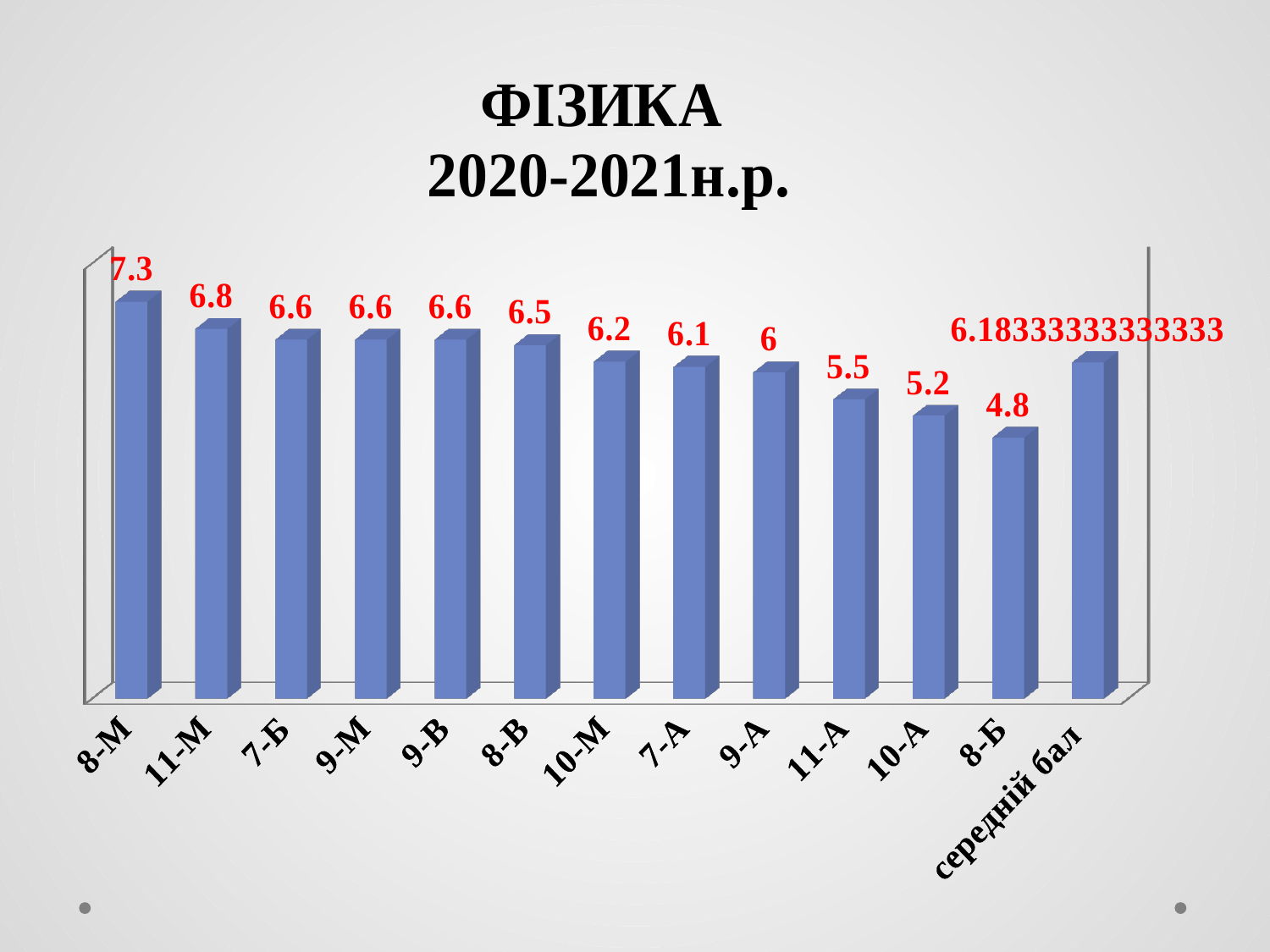
Which class has the highest value? 8-М What is the difference between the values for 11-М and 11-А? 1.3 Which is larger, the value for 7-А or the value for 8-В? 8-В What is the title of the chart? ФІЗИКА 2020-2021н.р. What is the value shown for середній бал? 6.18333333333333 What is the value for 8-М? 7.3 Which is larger, the value for 10-М or the value for 9-А? 10-М What kind of chart is shown on the slide? bar chart How many bars are plotted in the chart? 13 What is the difference between the values for 8-М and 8-Б? 2.5 What is the value for 10-А? 5.2 Which class has the lowest value? 8-Б